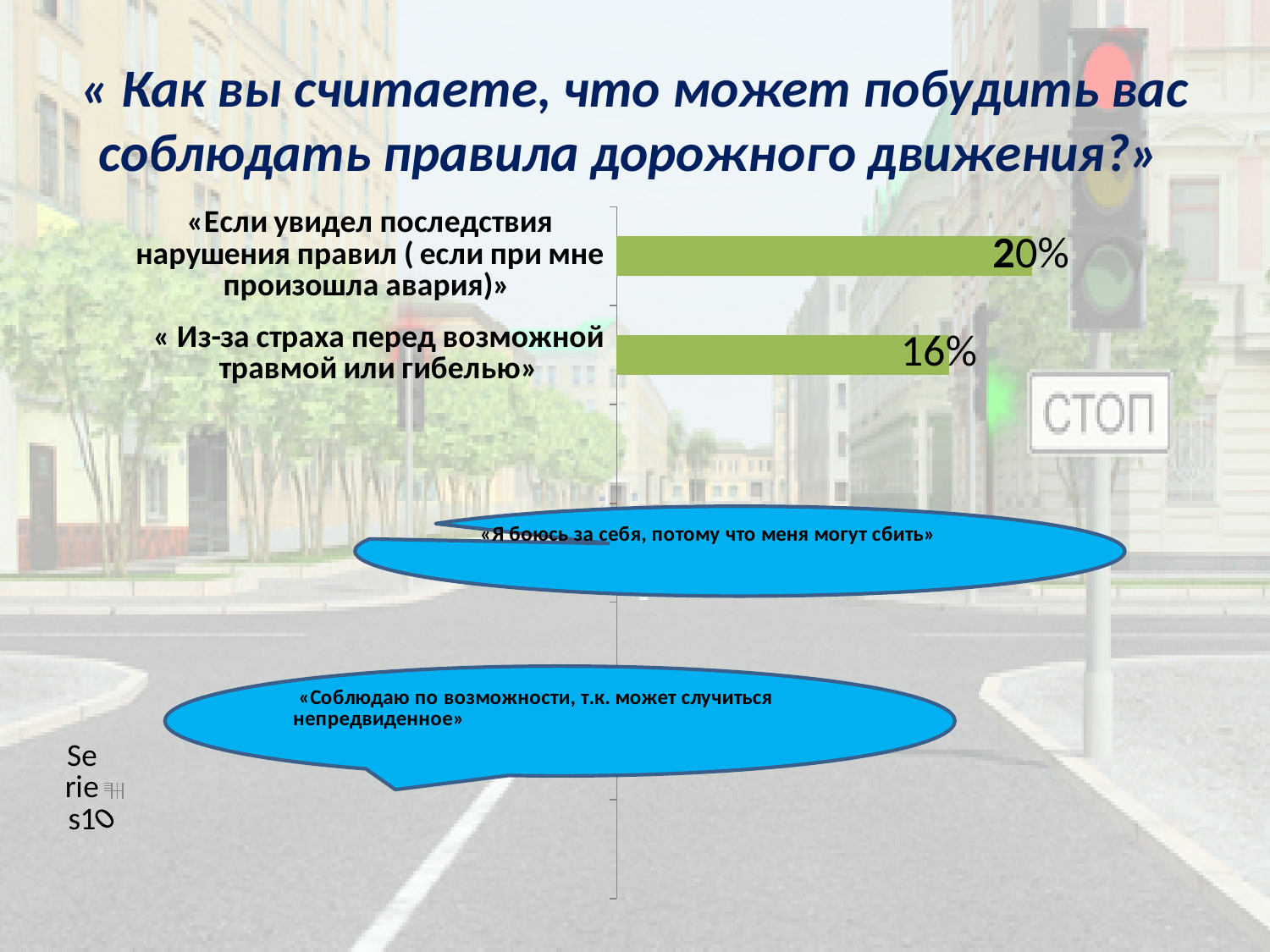
What colour are the bars in the chart? green Which of the two labelled bars has the higher value: «Если увидел последствия нарушения правил» or « Из-за страха перед возможной травмой или гибелью»? «Если увидел последствия нарушения правил» Are the bars in the chart oriented horizontally or vertically? horizontally What value is shown for the bar labelled « Из-за страха перед возможной травмой или гибелью»? 16% What value is shown for the bar labelled «Если увидел последствия нарушения правил ( если при мне произошла авария)»? 20% What is the difference between the values for «Если увидел последствия нарушения правил» (20%) and « Из-за страха перед возможной травмой или гибелью» (16%)? 4% Which of the two labelled bars has the lower value? « Из-за страха перед возможной травмой или гибелью» What kind of chart is shown on the slide? bar chart